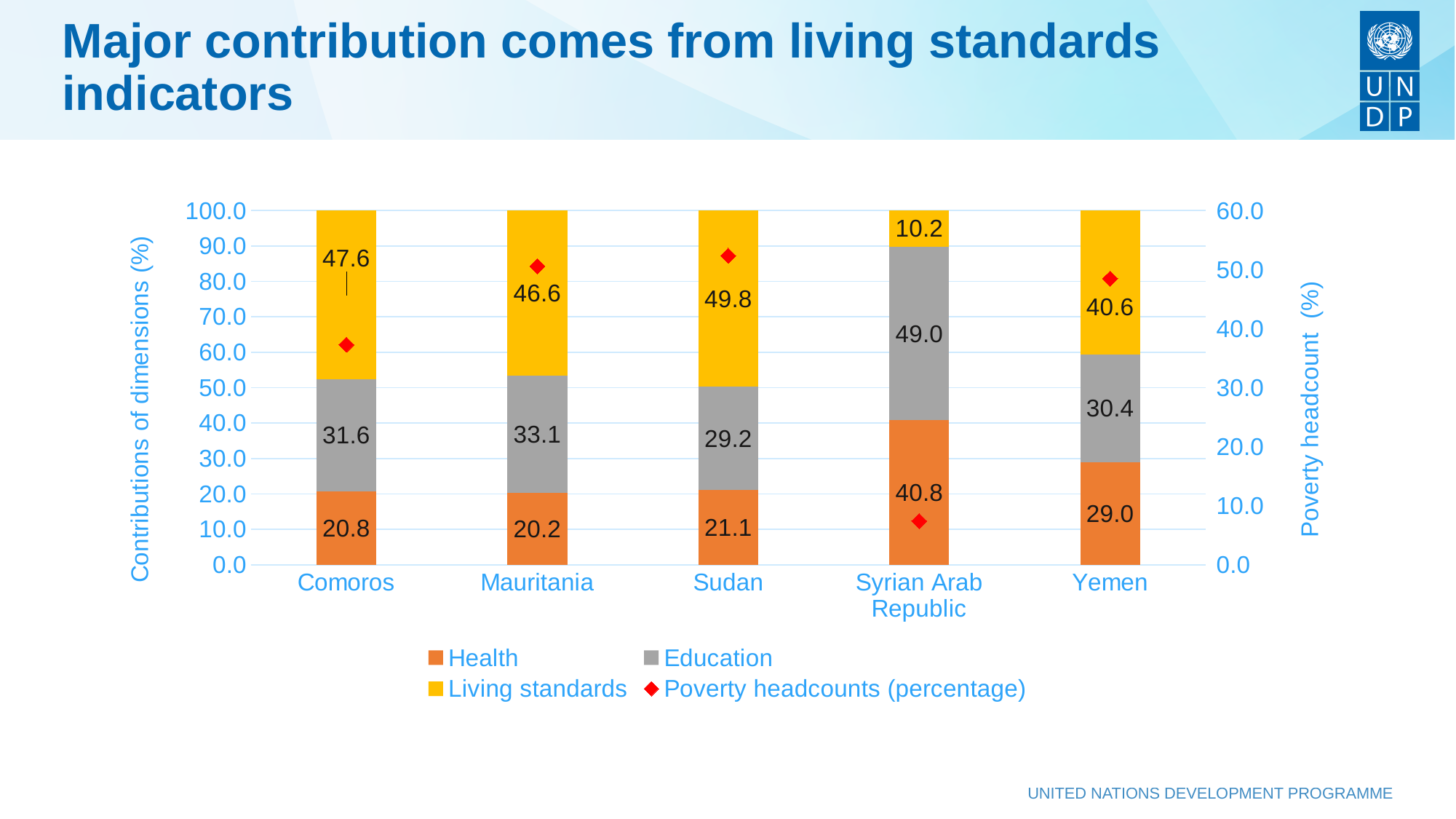
Which is larger, the Health contribution for Sudan or for Comoros? Sudan Which country has the lowest Health contribution? Mauritania Is the poverty headcount for the Syrian Arab Republic greater or less than 10.0? less What is the difference between the Education and Living standards contributions for the Syrian Arab Republic? 38.8 How many series does the legend list? 4 What is the Living standards contribution for the Syrian Arab Republic? 10.2 Which country has the highest Living standards contribution? Sudan What is the total of the stacked bar for Comoros? 100.0 What is the Health contribution for Yemen? 29.0 What is the Education contribution for Mauritania? 33.1 Is the poverty headcount for Comoros greater or less than 30.0? greater How many countries are shown on the x axis? 5